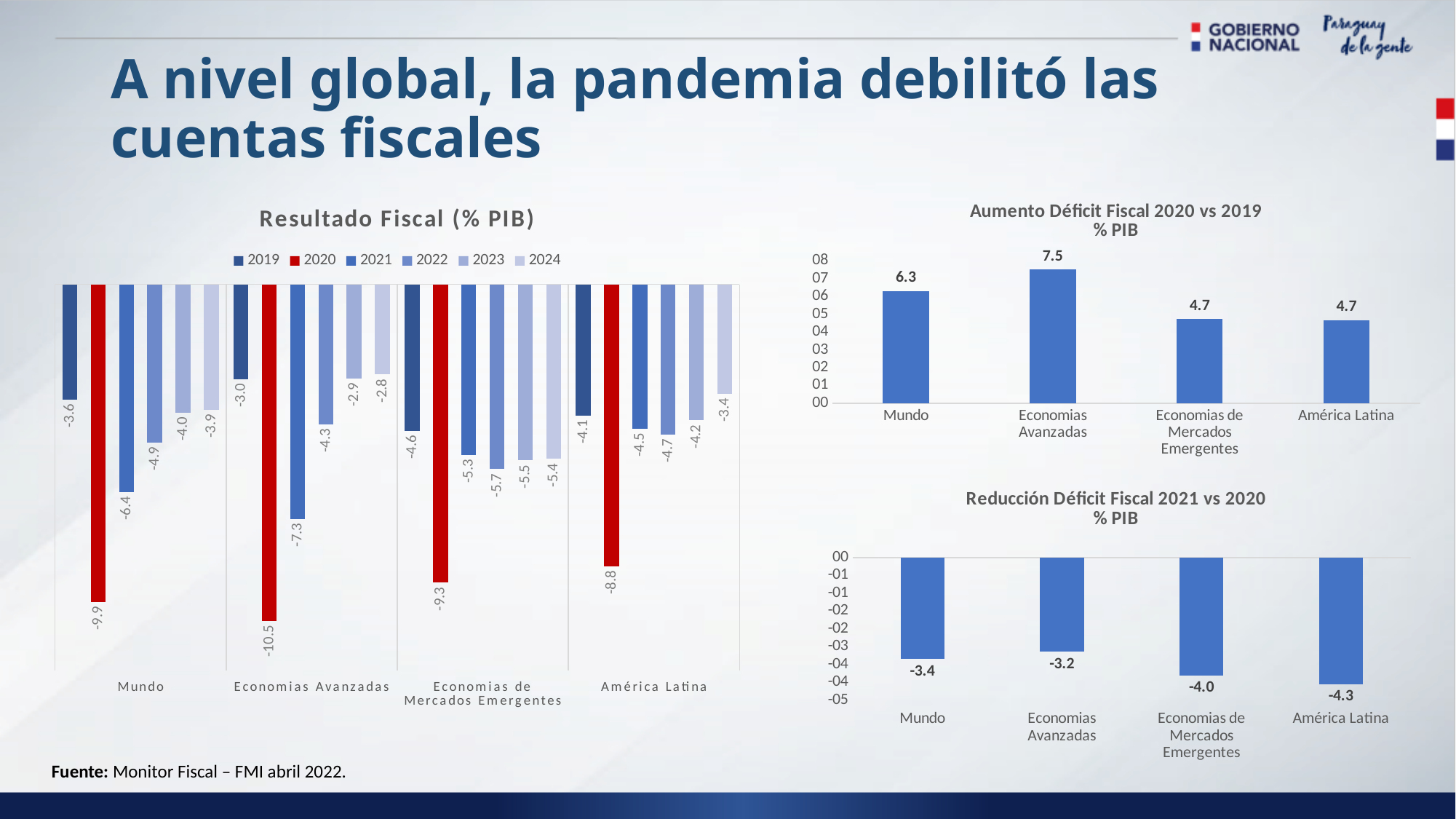
In the 'Resultado Fiscal (% PIB)' chart, what is the value for Economias Avanzadas in 2020? -10.5 In the 'Aumento Déficit Fiscal 2020 vs 2019 % PIB' chart, which category has the highest value? Economias Avanzadas What kind of chart is the 'Reducción Déficit Fiscal 2021 vs 2020 % PIB' chart? Bar chart In the 'Resultado Fiscal (% PIB)' chart, which category has the lowest value in 2020? Economias Avanzadas In the 'Reducción Déficit Fiscal 2021 vs 2020 % PIB' chart, what is the difference between the values for Economias de Mercados Emergentes and Economias Avanzadas? 0.8 In the 'Aumento Déficit Fiscal 2020 vs 2019 % PIB' chart, how many categories are shown? 4 In the 'Resultado Fiscal (% PIB)' chart, which is larger: the 2021 value for Mundo or the 2021 value for Economias de Mercados Emergentes? Economias de Mercados Emergentes In the 'Reducción Déficit Fiscal 2021 vs 2020 % PIB' chart, what is the value for América Latina? -4.3 In the 'Aumento Déficit Fiscal 2020 vs 2019 % PIB' chart, what is the value for Mundo? 6.3 In the 'Resultado Fiscal (% PIB)' chart, what is the difference between the Mundo values for 2019 and 2020? 6.3 In the 'Resultado Fiscal (% PIB)' chart, how many series does the legend list? 6 In the 'Resultado Fiscal (% PIB)' chart, what is the value for América Latina in 2024? -3.4